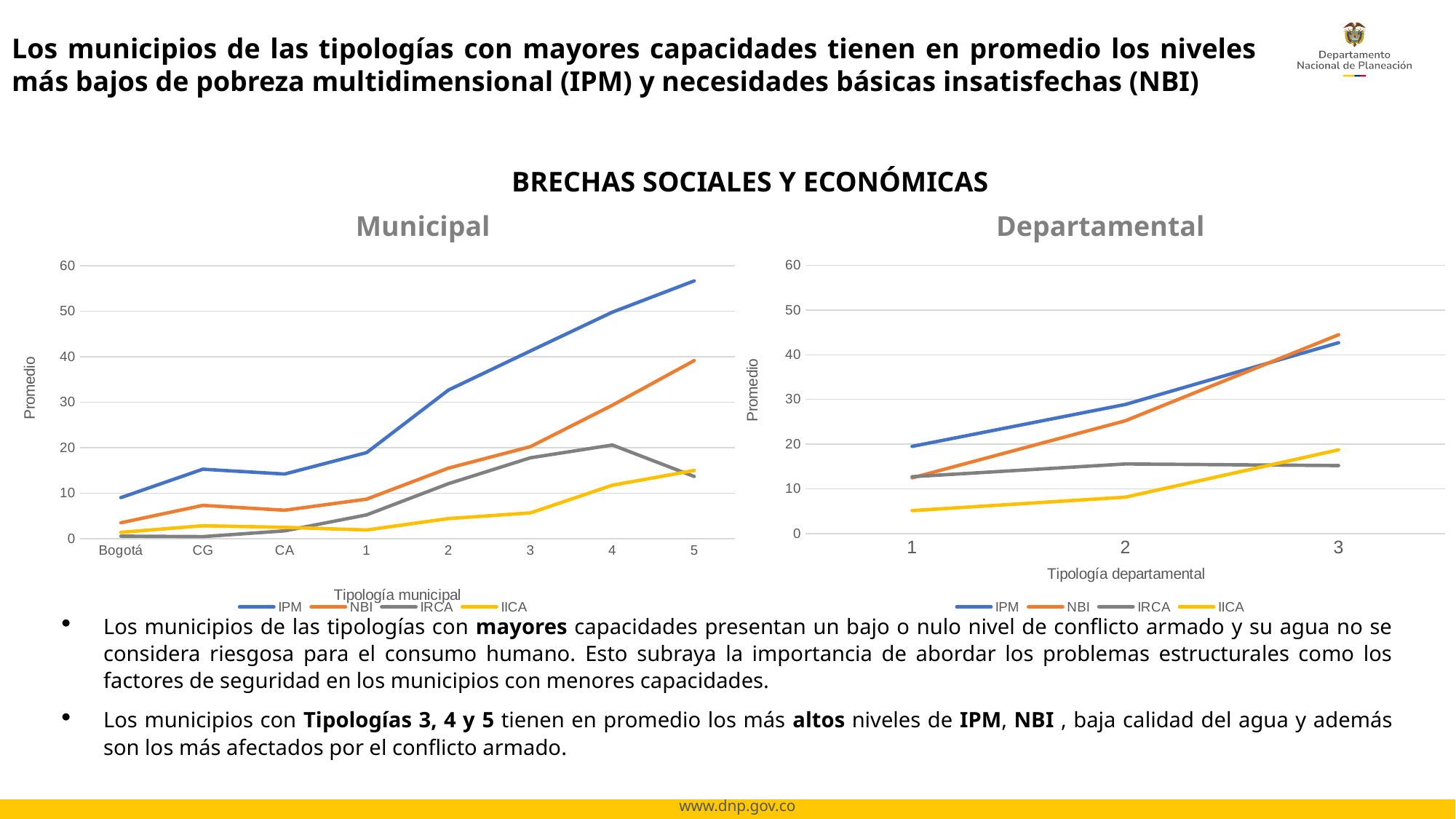
How many categories are shown on the x axis of the Municipal chart? 8 How many categories are shown on the x axis of the Departamental chart? 3 How many series does the legend of the Municipal chart list? 4 In the Municipal chart, is the IPM value for tipología 5 greater or less than 50? greater In the Municipal chart, which series has the highest value at tipología 5? IPM In the Departamental chart, which series has the lowest value at tipología 1? IICA In the Departamental chart, is the NBI value for tipología 3 greater or less than 40? greater In the Municipal chart, does the IPM series generally rise or fall from Bogotá to tipología 5? rise What kind of chart is the Municipal chart? line chart In the Departamental chart, is the IICA value for tipología 1 greater or less than 10? less What is the y-axis label of the Departamental chart? Promedio